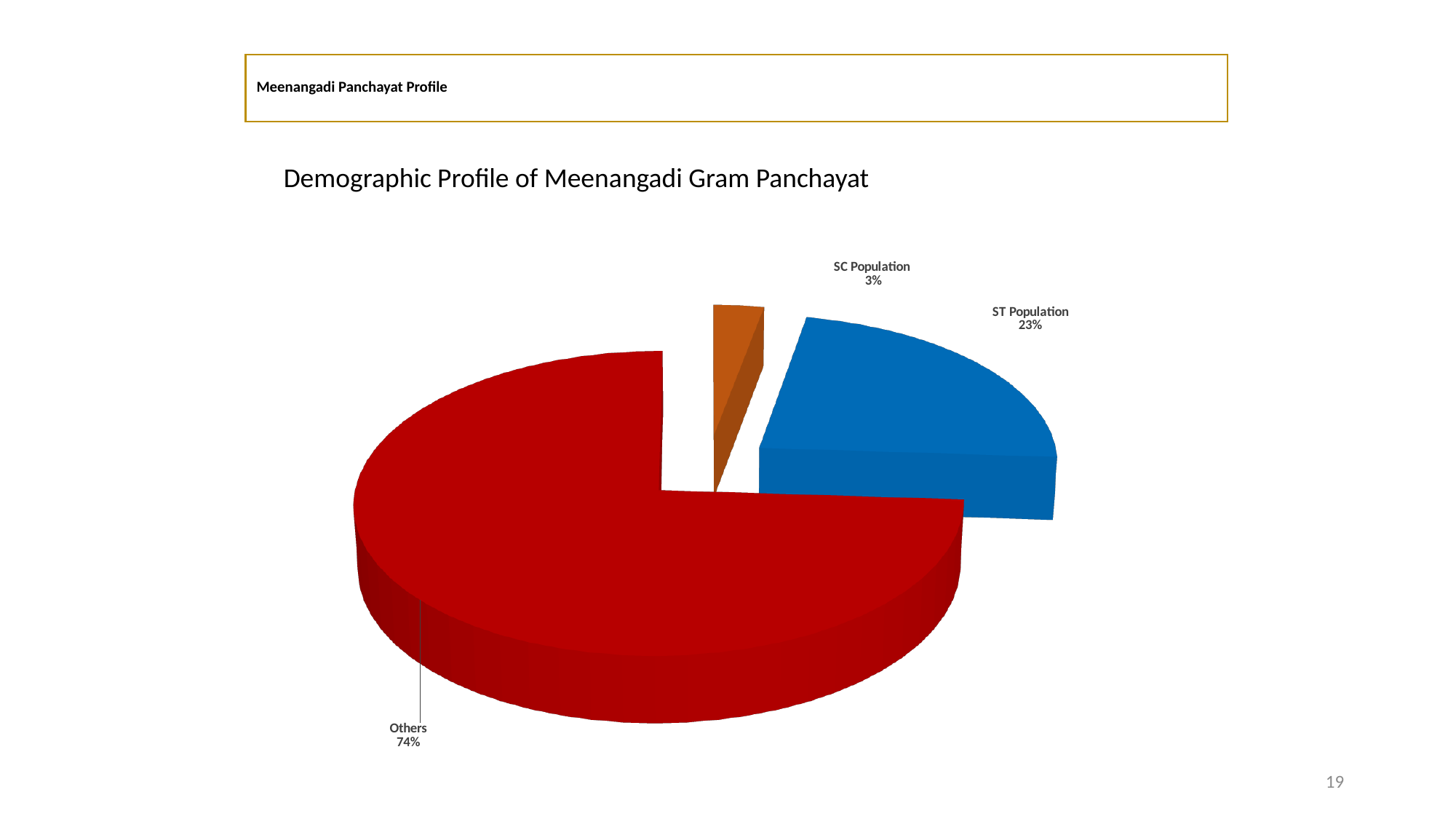
What is the difference in percentage points between Others and ST Population? 51 What share of the pie does SC Population represent? 3% Which is larger, ST Population or SC Population? ST Population What colour is the slice for ST Population? Blue How many slices does the pie chart have? 3 What is the difference in percentage points between ST Population and SC Population? 20 Which category has the largest slice of the pie? Others Which category has the smallest slice of the pie? SC Population What share of the pie does ST Population represent? 23% What is the title of the chart? Demographic Profile of Meenangadi Gram Panchayat What kind of chart is shown on the slide? Pie chart What share of the pie does Others represent? 74%